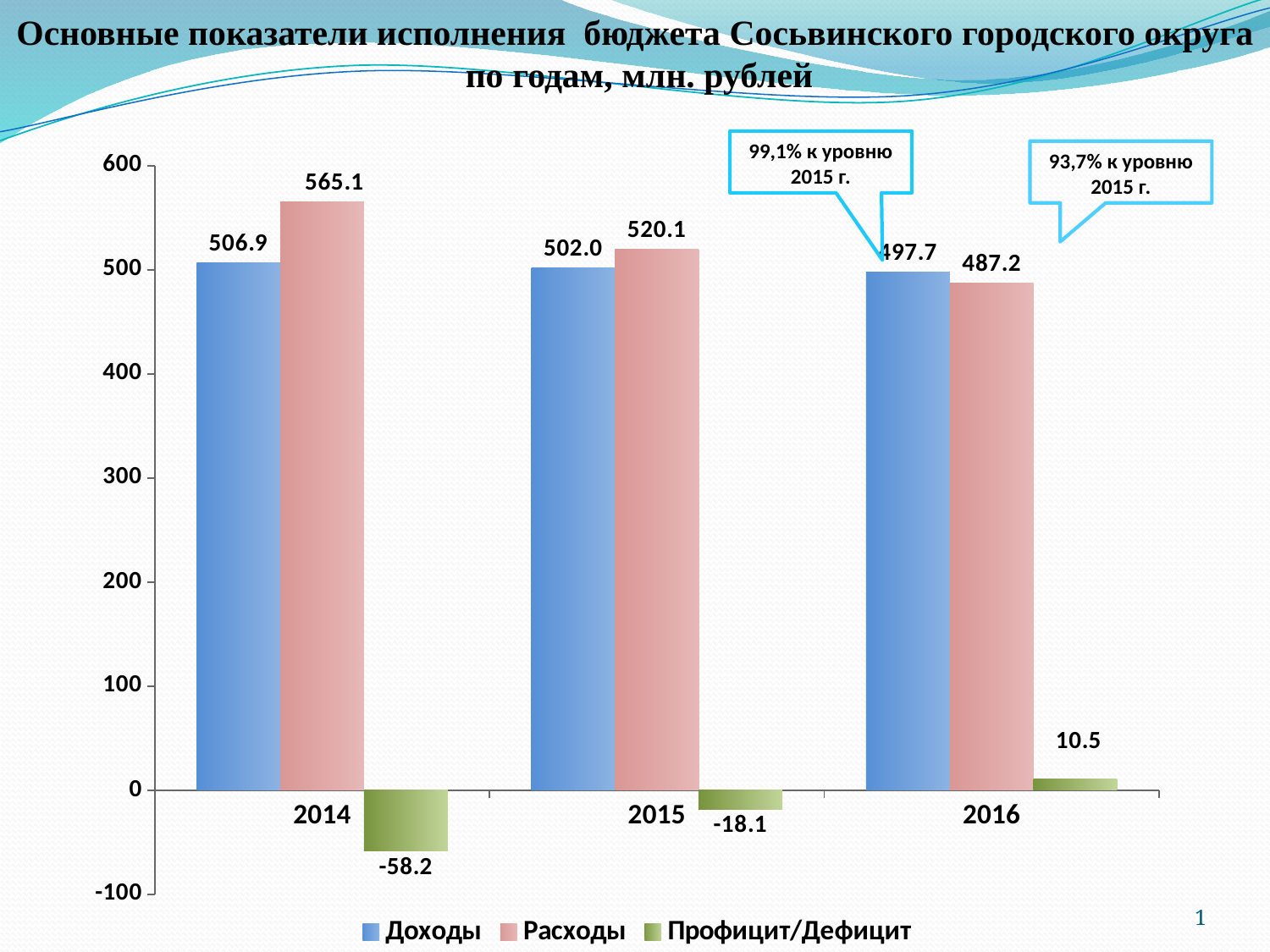
What kind of chart is shown on the slide? bar chart How many years are shown on the x axis? 3 In which year is Доходы lowest? 2016 Is the value of Расходы for 2016 greater or less than 500? less What is the difference between Расходы and Доходы in 2014? 58.2 What is the value of Расходы for 2015? 520.1 What is the value of Профицит/Дефицит for 2016? 10.5 What is the value of Доходы for 2014? 506.9 In which year is Расходы highest? 2014 What is the value of Профицит/Дефицит for 2014? -58.2 How many series does the legend list? 3 Which is larger in 2016, Доходы or Расходы? Доходы